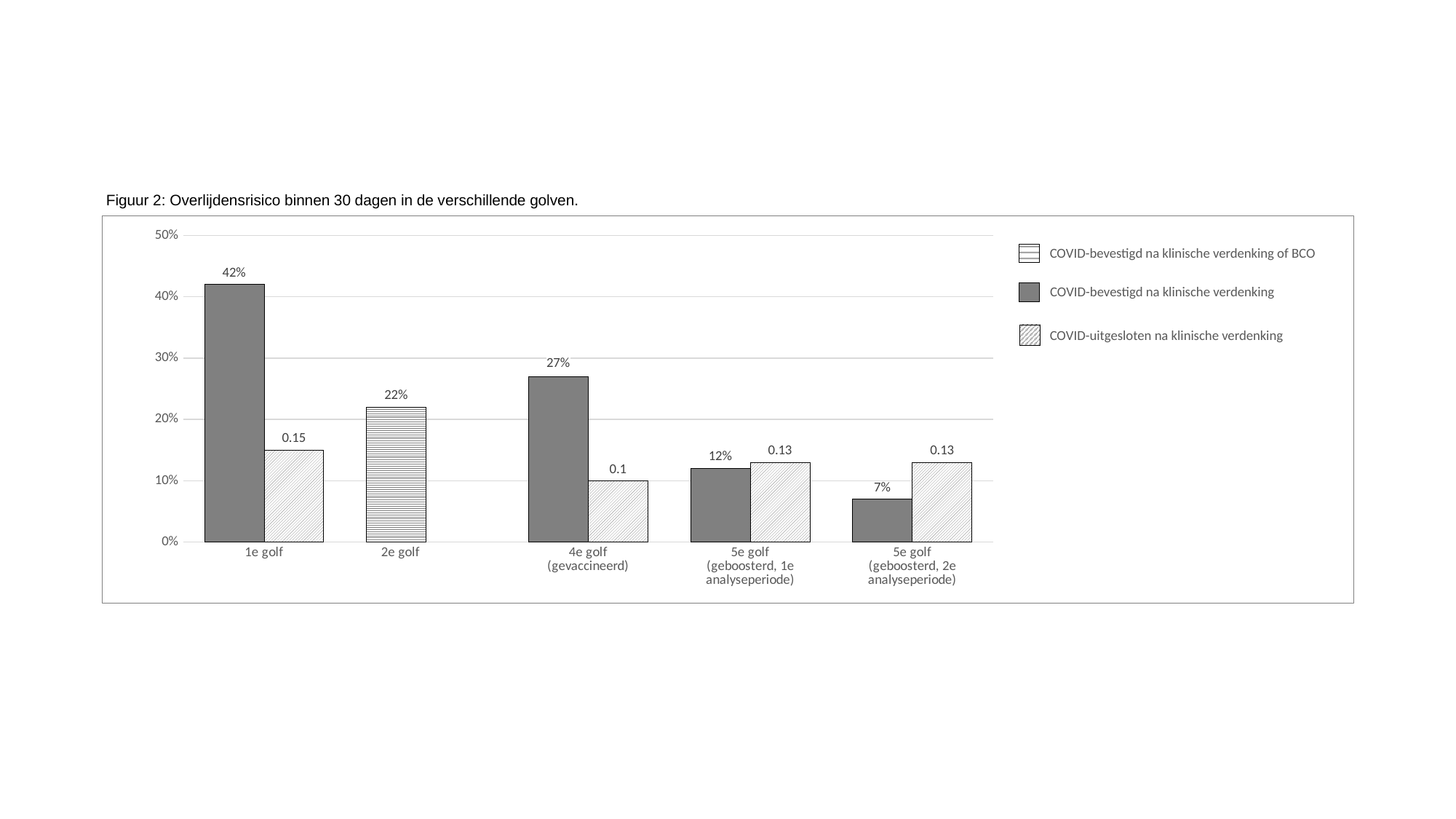
In the 5e golf (geboosterd, 1e analyseperiode), which is larger: 'COVID-bevestigd na klinische verdenking' or 'COVID-uitgesloten na klinische verdenking'? COVID-uitgesloten na klinische verdenking Which category has the lowest value for 'COVID-bevestigd na klinische verdenking'? 5e golf (geboosterd, 2e analyseperiode) What is the value for 'COVID-bevestigd na klinische verdenking' in the 1e golf? 42% What is the value shown for the 2e golf? 22% How many series does the legend list? 3 What is the value for 'COVID-uitgesloten na klinische verdenking' in the 4e golf (gevaccineerd)? 0.1 Which series is shown with a solid dark grey fill in the legend? COVID-bevestigd na klinische verdenking Which category has the highest value for 'COVID-bevestigd na klinische verdenking'? 1e golf What is the difference between the 'COVID-bevestigd na klinische verdenking' values for the 1e golf and the 4e golf (gevaccineerd)? 15 percentage points What is the value for 'COVID-bevestigd na klinische verdenking' in the 5e golf (geboosterd, 2e analyseperiode)? 7% What type of chart is shown on the slide? bar chart How many categories (golven) are shown on the x axis? 5